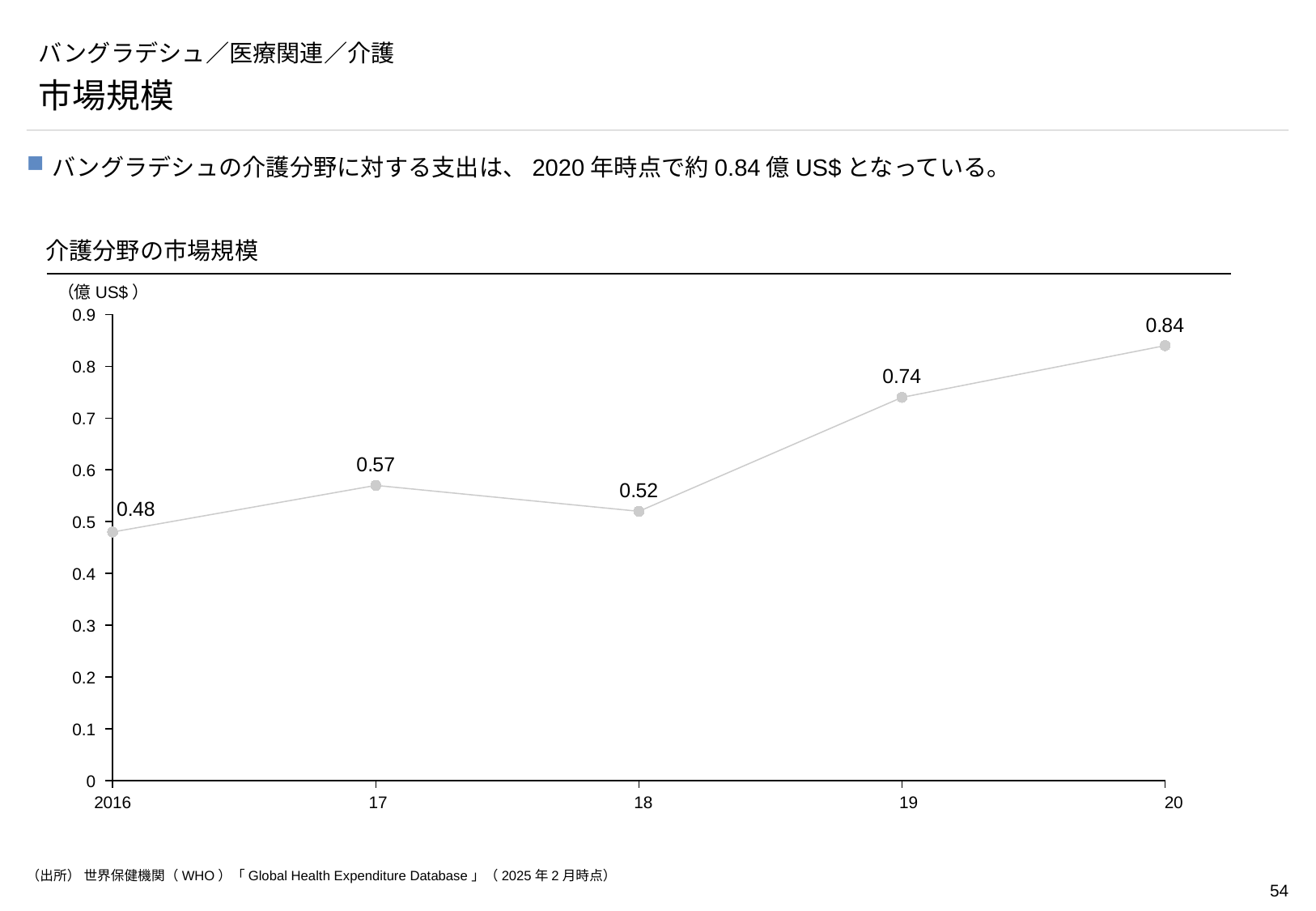
What is the value for 2016? 0.48 What kind of chart is shown on the slide? line chart Which is larger, the value for 2017 or the value for 2018? 2017 What unit is shown on the chart's vertical axis? 億 US$ Is the value for 2019 greater or less than 0.7? greater How many data points are plotted on the chart? 5 Which year has the highest value? 2020 What is the difference between the values for 2020 and 2019? 0.1 Which year has the lowest value? 2016 What is the value for 2018? 0.52 What is the difference between the values for 2017 and 2018? 0.05 What is the value for 2020? 0.84